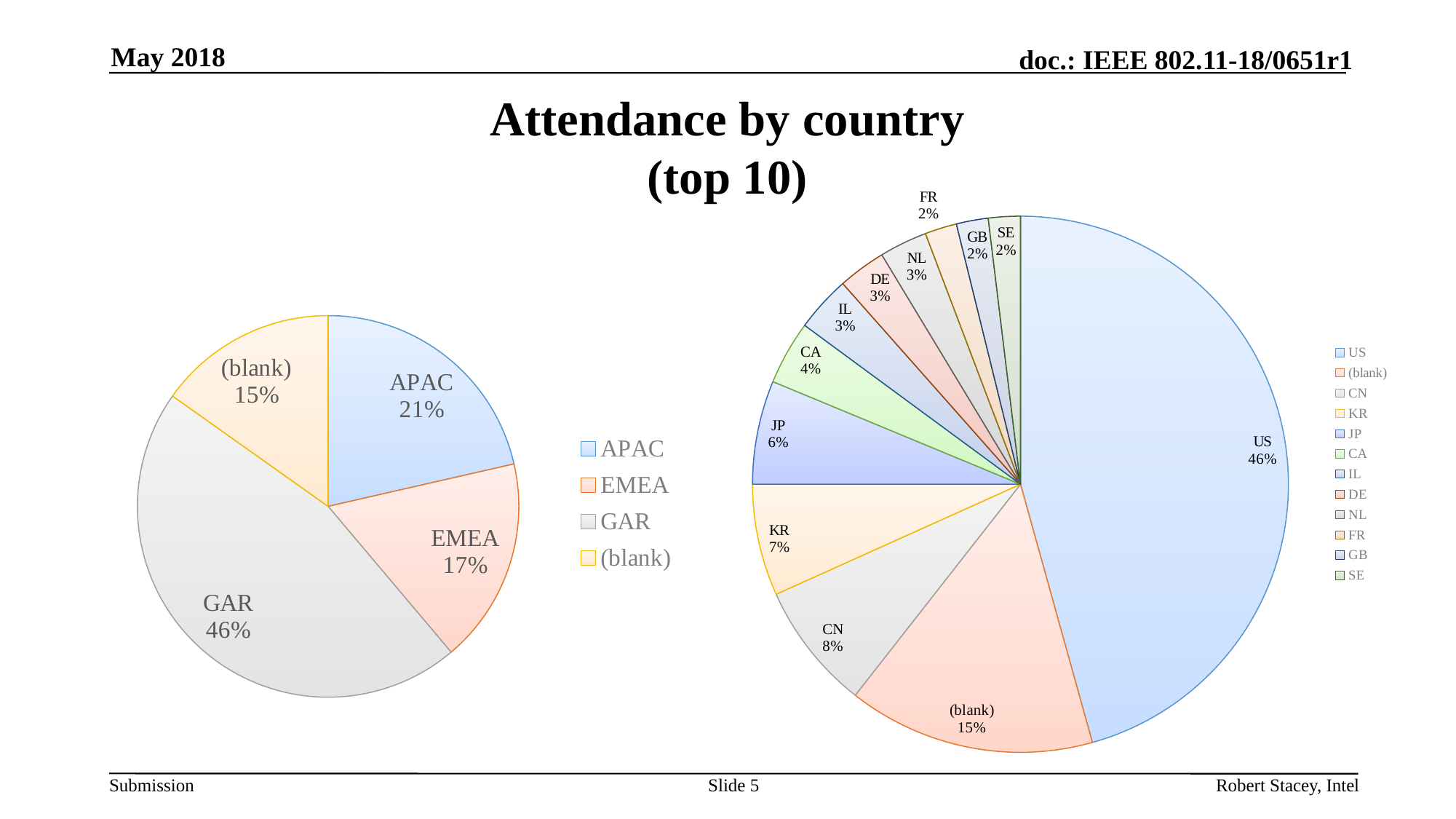
What type of chart is shown on the right of the slide? Pie chart In the pie chart on the right, which is larger, CN or JP? CN In the pie chart on the left, what share does GAR have? 46% In the pie chart on the left, what is the difference in percentage points between APAC and EMEA? 4 In the pie chart on the right, what share does KR have? 7% In the pie chart on the right, what share does US have? 46% In the pie chart on the left, what share does APAC have? 21% In the pie chart on the left, how many slices are there? 4 In the pie chart on the left, which category has the largest slice? GAR In the pie chart on the right, which country has the largest slice? US In the pie chart on the right, how many entries does the legend list? 12 In the pie chart on the left, which category has the smallest slice? (blank)